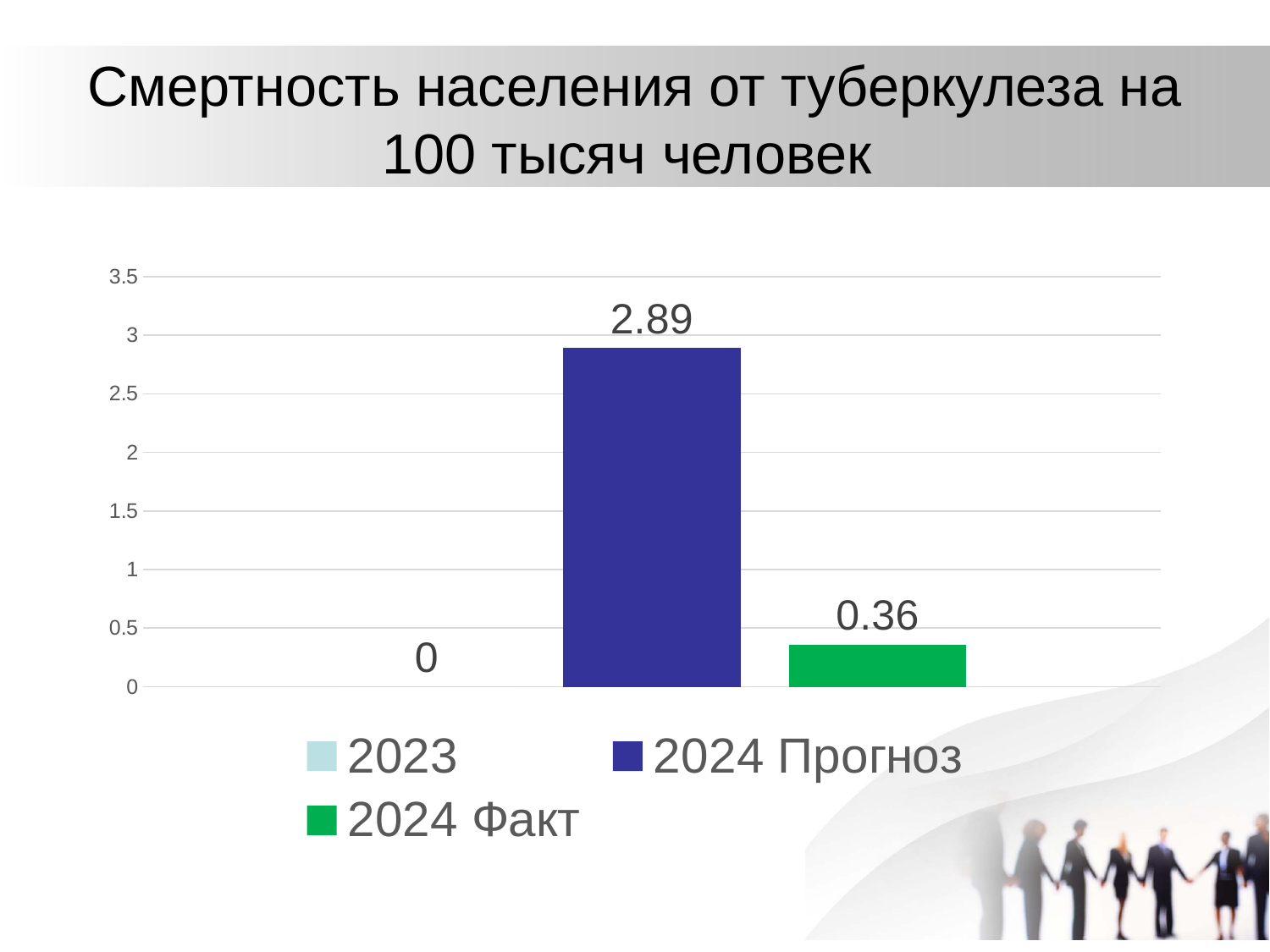
What is the title of the slide? Смертность населения от туберкулеза на 100 тысяч человек Which series has the highest value? 2024 Прогноз Which is larger, the value for 2024 Прогноз or the value for 2024 Факт? 2024 Прогноз What kind of chart is shown on the slide? bar chart What is the value for 2024 Прогноз? 2.89 What is the difference between the 2024 Прогноз and 2024 Факт values? 2.53 What is the value for 2024 Факт? 0.36 Which series has the lowest value? 2023 Is the value for 2024 Факт greater or less than 0.5? less How many series does the legend list? 3 What is the value for 2023? 0 Is the value for 2024 Прогноз greater or less than 2.5? greater